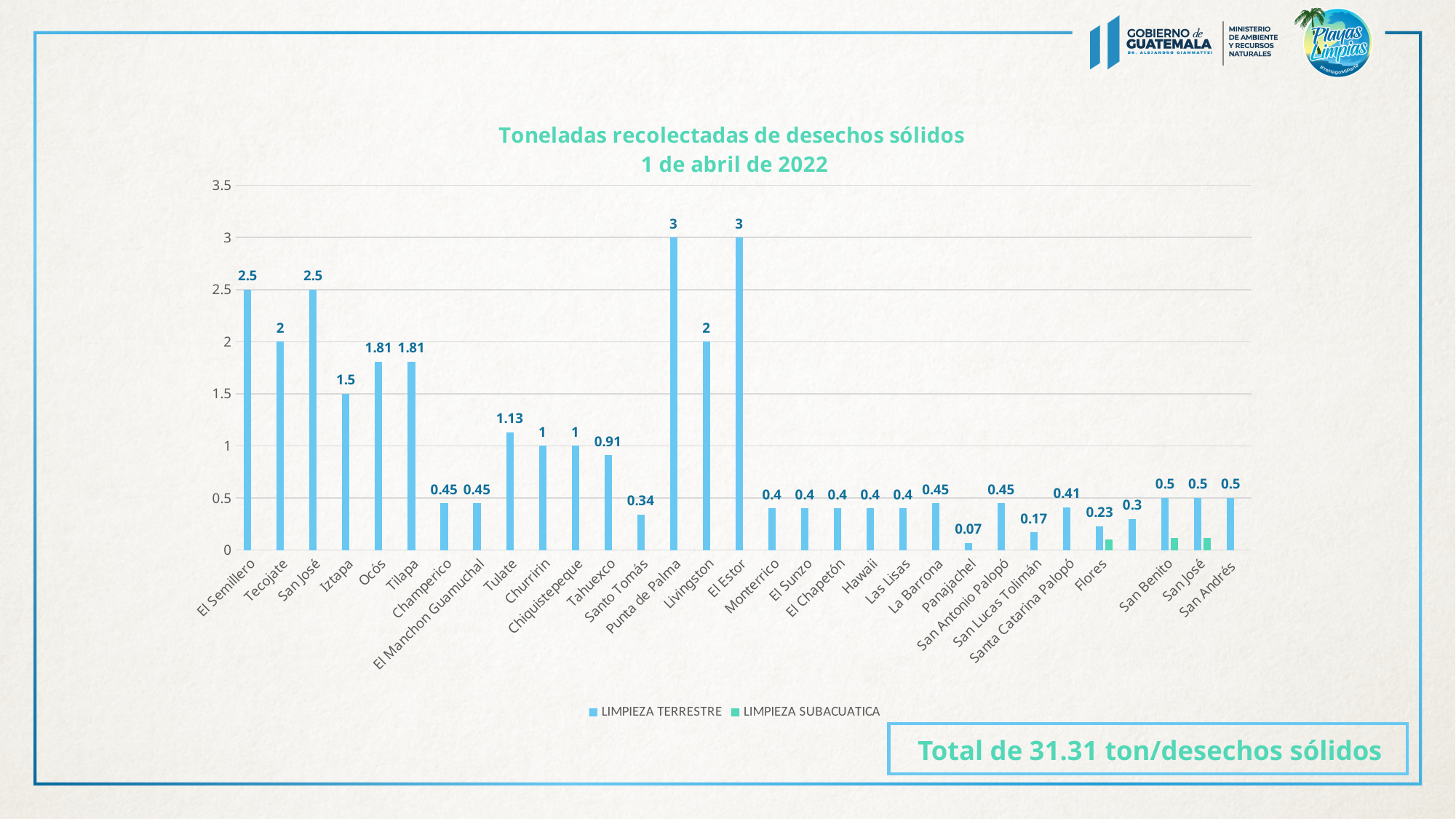
What is the title of the chart? Toneladas recolectadas de desechos sólidos 1 de abril de 2022 Which has a larger Limpieza Terrestre value, Iztapa or Tahuexco? Iztapa What total is stated in the box below the chart? Total de 31.31 ton/desechos sólidos How many series does the legend list? 2 Is the Limpieza Subacuatica value for Flores greater or less than 0.5? less What is the difference between the Limpieza Terrestre values for Livingston and Santo Tomás? 1.66 What is the difference between the Limpieza Terrestre values for El Semillero and Tecojate? 0.5 What is the Limpieza Terrestre value for Santa Catarina Palopó? 0.41 Which location has the lowest Limpieza Terrestre value? Panajachel What is the Limpieza Terrestre value for Tulate? 1.13 What is the Limpieza Terrestre value for Punta de Palma? 3 What kind of chart is shown on the slide? bar chart